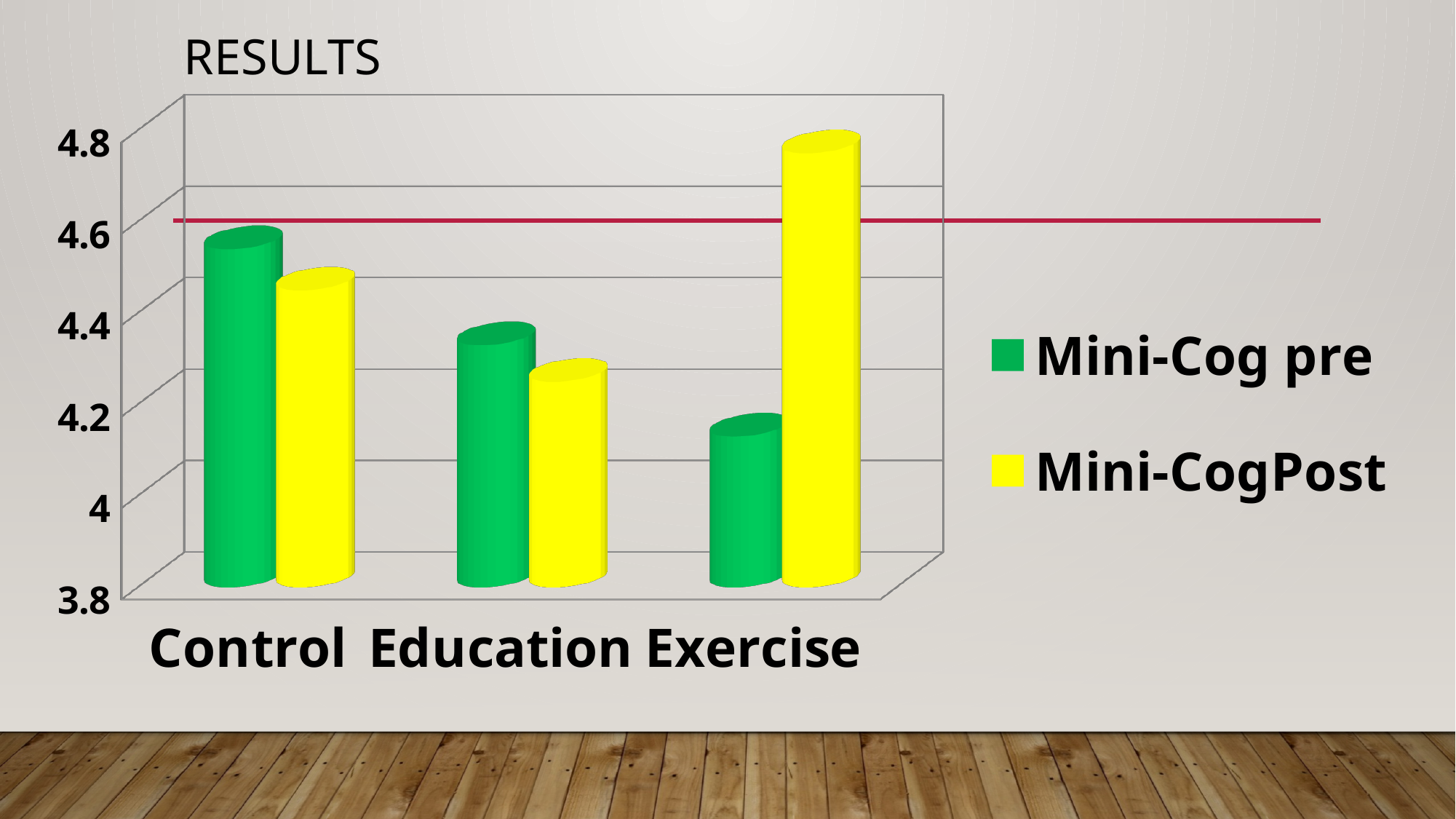
For the Control group, which is larger: Mini-Cog pre or Mini-CogPost? Mini-Cog pre Is the Mini-Cog pre value for Exercise greater or less than 4.4? less Which category has the highest Mini-CogPost value? Exercise What colour represents the Mini-CogPost series in the chart? yellow How many series does the chart's legend list? 2 How many categories are shown on the x axis of the chart? 3 Which category has the lowest Mini-Cog pre value? Exercise What kind of chart is shown on the slide? bar chart Which category has the highest Mini-Cog pre value? Control Do the Mini-Cog pre values rise or fall moving from Control to Education to Exercise? fall Is the Mini-CogPost value for Exercise greater or less than 4.6? greater For the Exercise group, which is larger: Mini-Cog pre or Mini-CogPost? Mini-CogPost